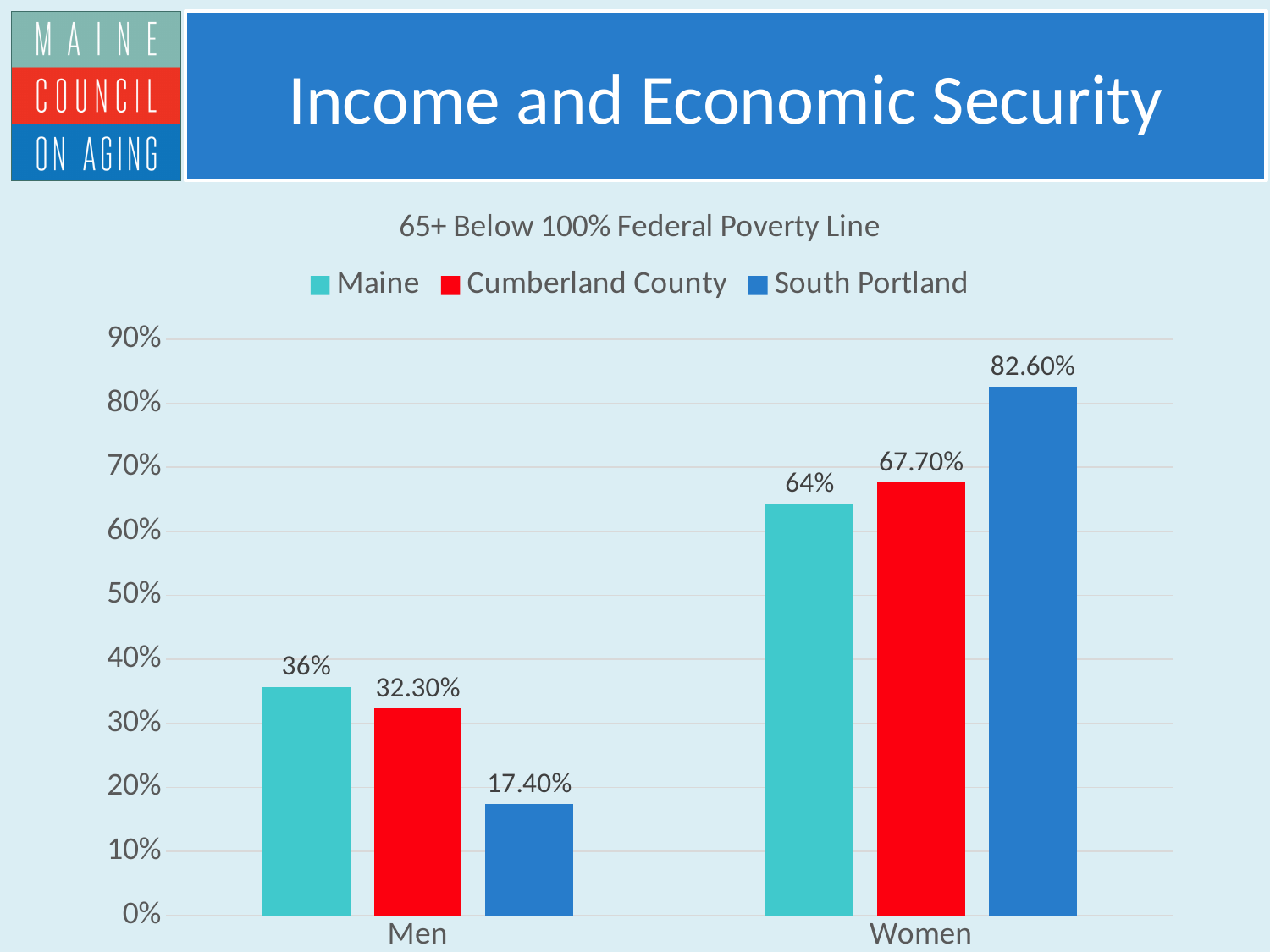
What is the value for Maine in the Women category? 64% What is the title of the chart? 65+ Below 100% Federal Poverty Line What is the difference between the South Portland values for Women and Men? 65.20% Is the value for South Portland in the Men category greater or less than 20%? less What is the value for Cumberland County in the Men category? 32.30% Which series has the highest value in the Women category? South Portland What is the value for South Portland in the Women category? 82.60% What is the difference between the Maine values for Women and Men? 28% Which is larger, the Maine value for Men or the Cumberland County value for Men? Maine Which series has the lowest value in the Men category? South Portland How many categories are shown on the x axis? 2 How many series does the legend list? 3